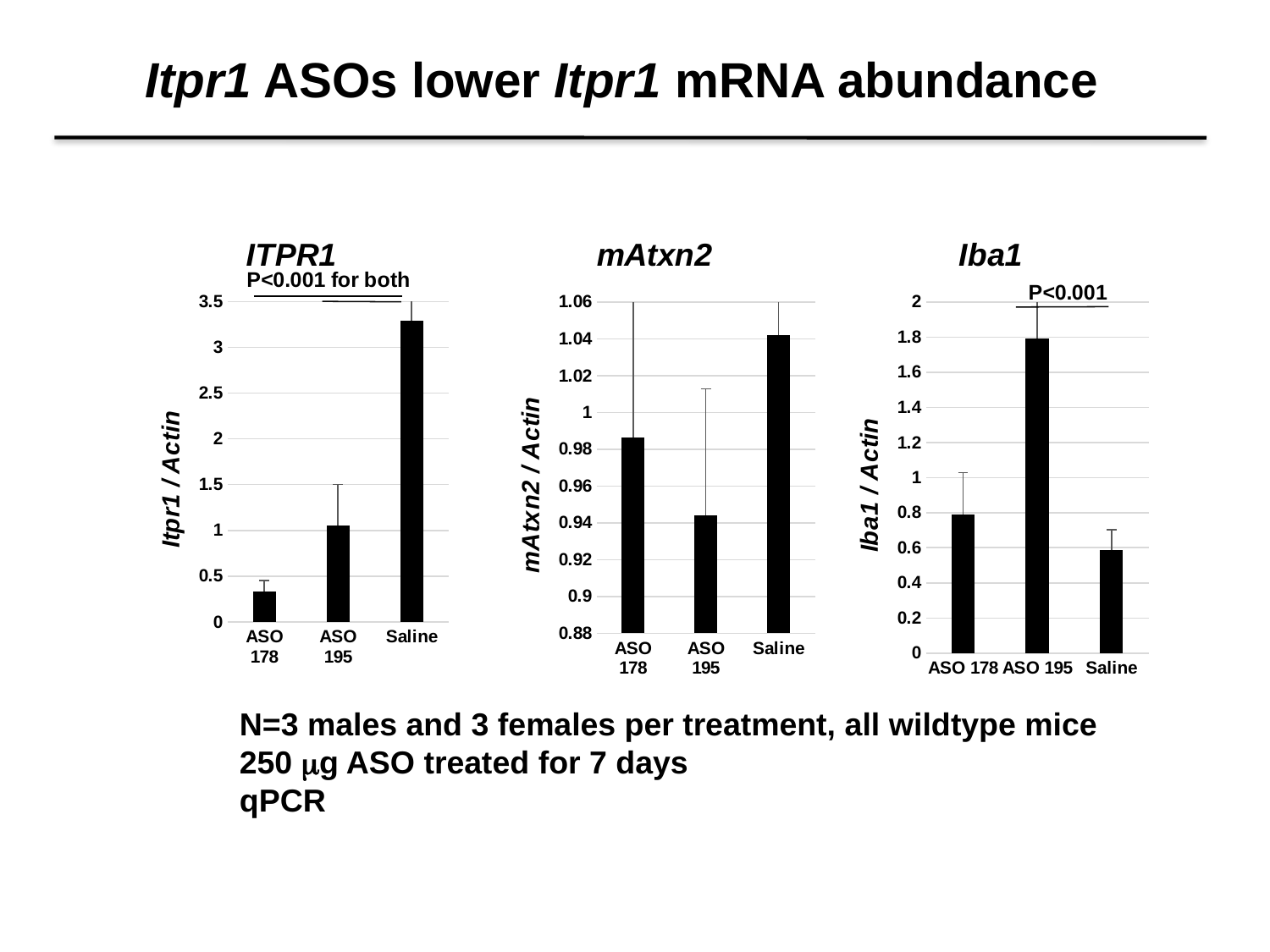
How many treatment categories are shown in the Iba1 chart? 3 In the ITPR1 chart, which treatment has the highest Itpr1 / Actin value? Saline In the Iba1 chart, which treatment has the highest Iba1 / Actin value? ASO 195 In the ITPR1 chart, which treatment has the lowest Itpr1 / Actin value? ASO 178 In the ITPR1 chart, is the value for ASO 178 greater or less than 0.5? less In the ITPR1 chart, is the value for Saline greater or less than 3? greater In the Iba1 chart, which treatment has the lowest Iba1 / Actin value? Saline In the Iba1 chart, is the value for ASO 195 greater or less than 1.6? greater In the mAtxn2 chart, which treatment has the highest mAtxn2 / Actin value? Saline In the mAtxn2 chart, which treatment has the lowest mAtxn2 / Actin value? ASO 195 What kind of chart is the mAtxn2 chart? Bar chart